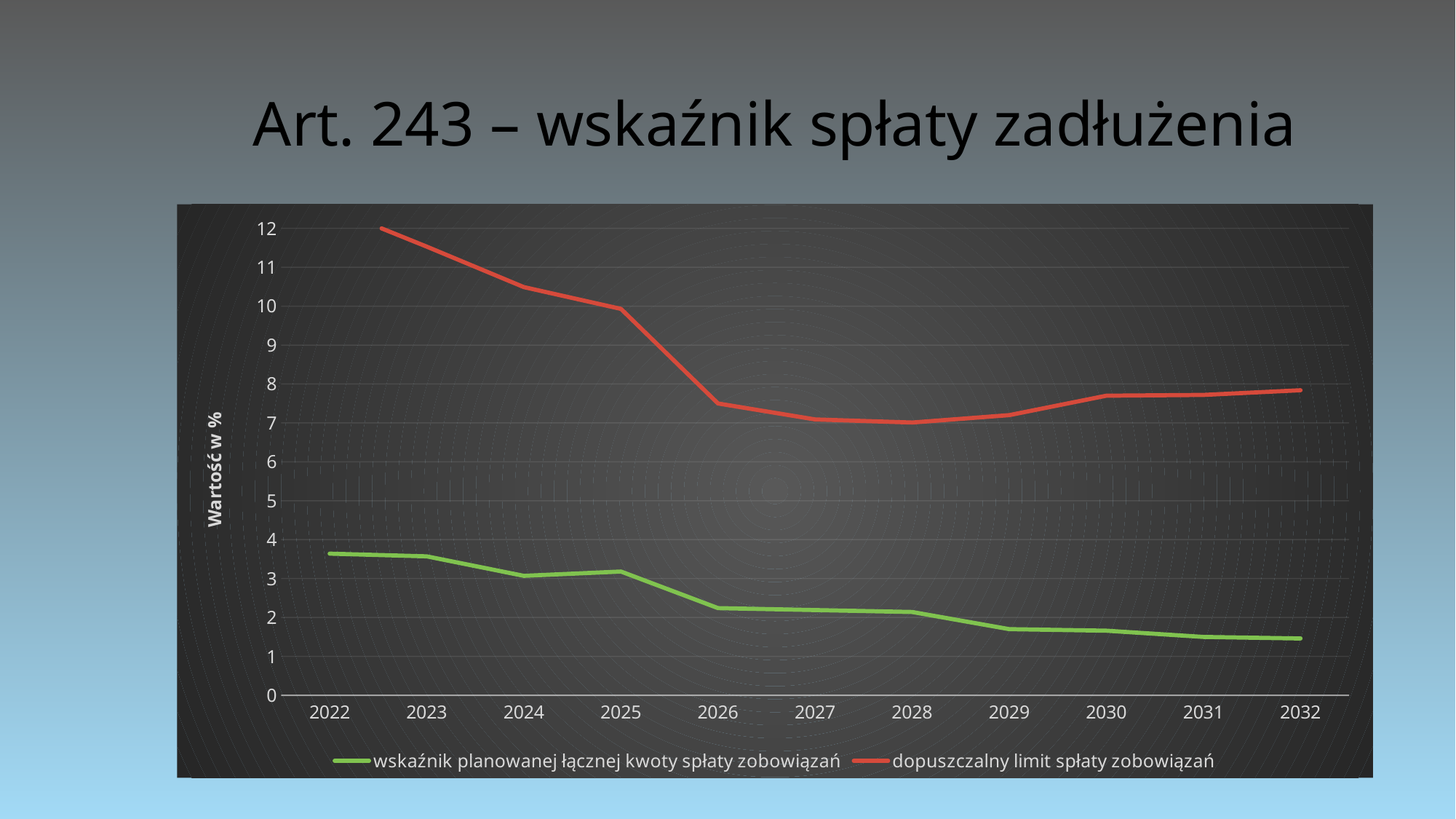
What is the title of the vertical axis? Wartość w % What kind of chart is shown on the slide? line chart Which series has the higher value in 2028, 'wskaźnik planowanej łącznej kwoty spłaty zobowiązań' or 'dopuszczalny limit spłaty zobowiązań'? dopuszczalny limit spłaty zobowiązań In which year is 'wskaźnik planowanej łącznej kwoty spłaty zobowiązań' at its highest? 2022 How many series does the legend list? 2 Is the value of 'wskaźnik planowanej łącznej kwoty spłaty zobowiązań' in 2032 greater or less than 2? less Is the value of 'dopuszczalny limit spłaty zobowiązań' in 2024 greater or less than 10? greater How many years are shown on the x axis? 11 In which year is 'wskaźnik planowanej łącznej kwoty spłaty zobowiązań' at its lowest? 2032 Does the 'wskaźnik planowanej łącznej kwoty spłaty zobowiązań' line generally rise or fall from 2022 to 2032? fall Is the value of 'dopuszczalny limit spłaty zobowiązań' in 2026 greater or less than 8? less